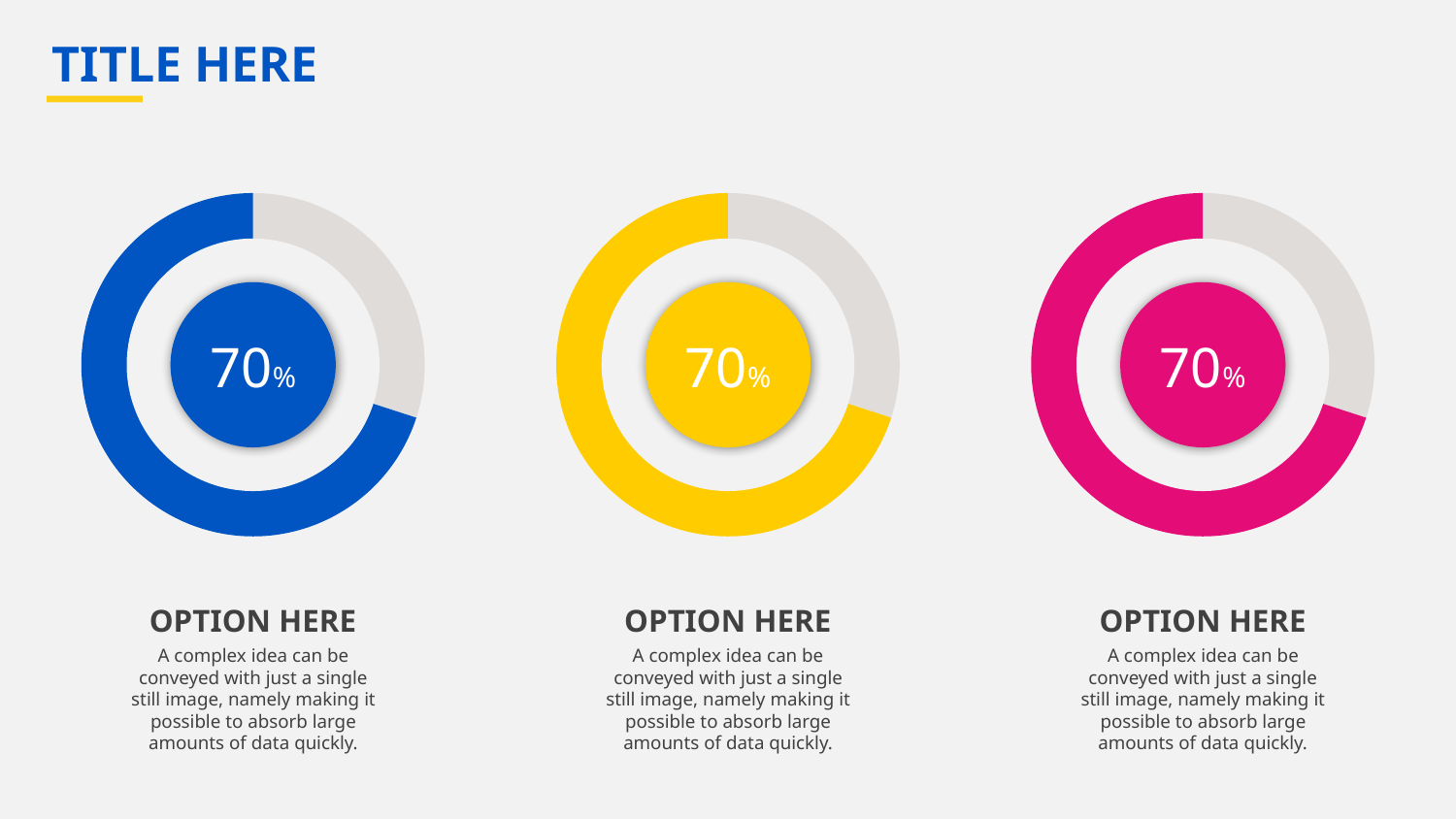
What is the difference between the values shown in the middle and right donut charts? 0% How many donut charts are on the slide? 3 Is the value shown in the left donut chart larger than, smaller than, or equal to the value in the right donut chart? Equal What colour is the filled segment of the right donut chart? Pink What kind of chart is used for each of the three figures on the slide? Donut chart Is the value shown in the middle donut chart greater or less than 50%? greater What colour is the filled segment of the left donut chart? Blue What value is shown in the centre of the left donut chart? 70% What share of the left donut chart is filled with the coloured segment? 70% What value is shown in the centre of the middle donut chart? 70% What value is shown in the centre of the right donut chart? 70%